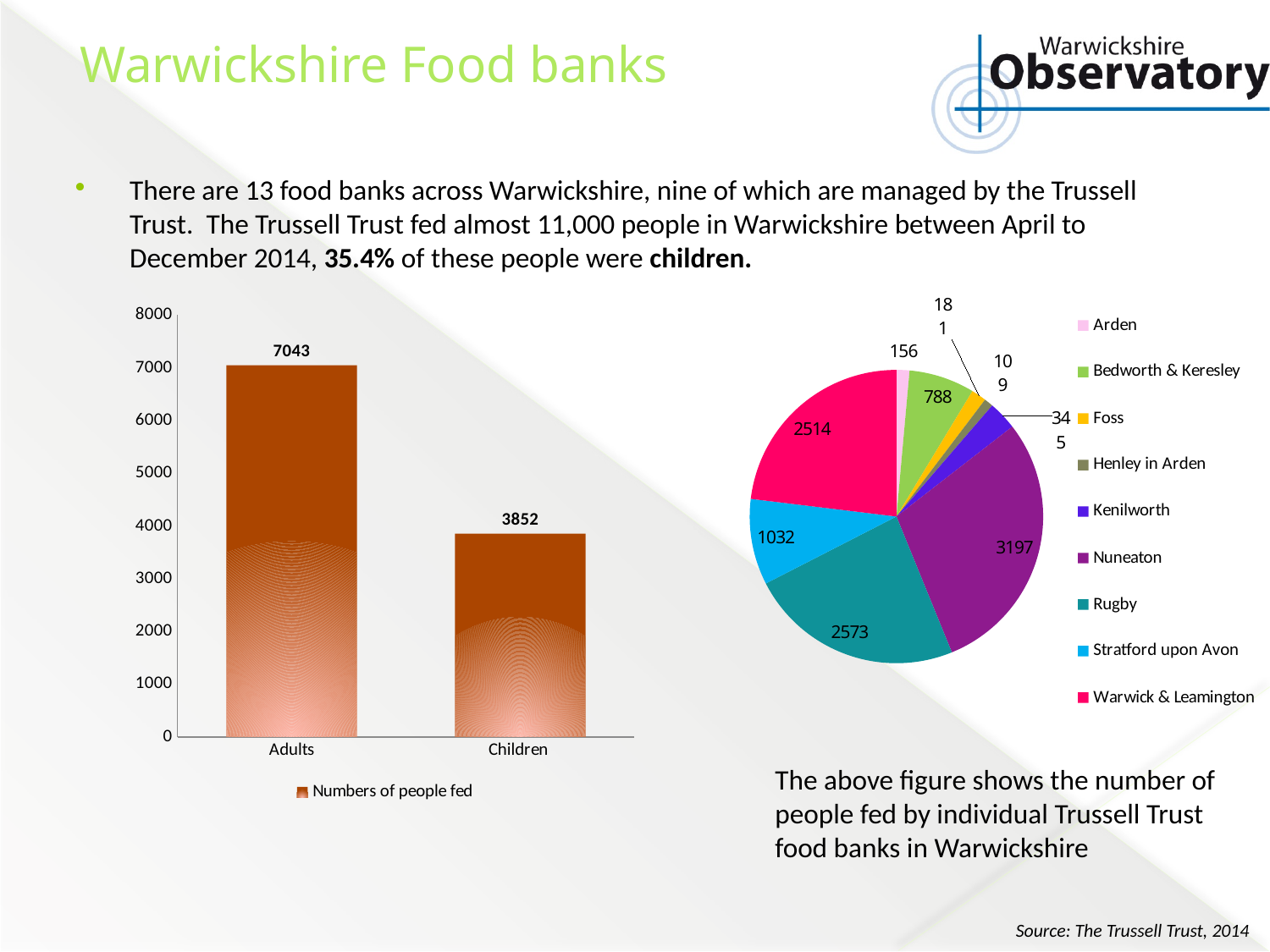
In the bar chart on the left, how many adults were fed? 7043 In the pie chart on the right, how many people were fed by the Stratford upon Avon food bank? 1032 How many food banks are listed in the legend of the pie chart on the right? 9 In the bar chart on the left, what is the difference between the number of adults and the number of children fed? 3191 In the pie chart on the right, which food bank fed the most people? Nuneaton What type of chart is the chart on the left of the slide? Bar chart In the bar chart on the left, how many categories are shown on the x axis? 2 In the bar chart on the left, what series name does the legend show? Numbers of people fed In the pie chart on the right, how many people were fed by the Nuneaton food bank? 3197 In the bar chart on the left, how many children were fed? 3852 In the pie chart on the right, how many people were fed by the Rugby food bank? 2573 In the pie chart on the right, which fed more people: Rugby or Warwick & Leamington? Rugby